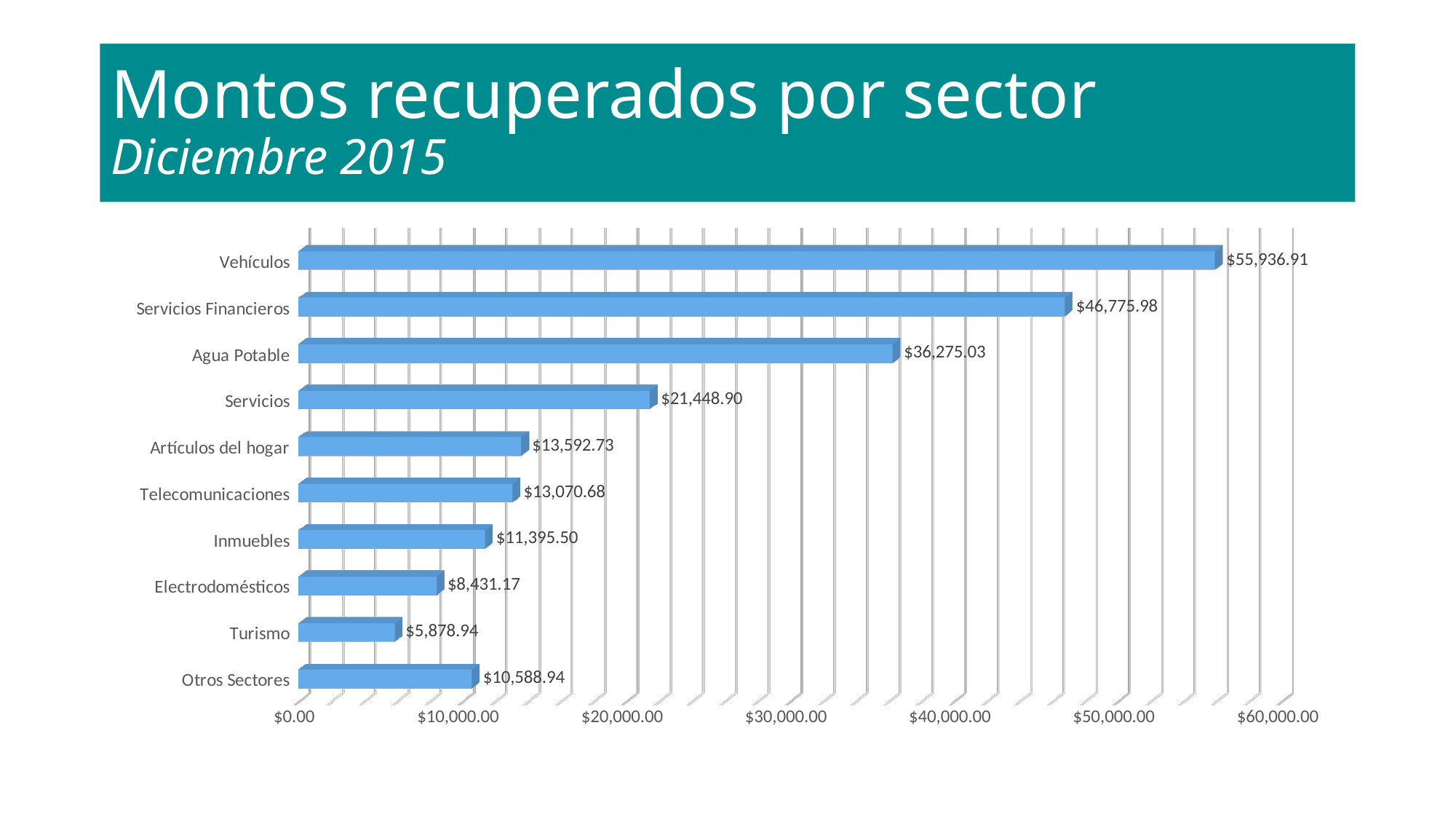
Which sector has the highest recovered amount? Vehículos What kind of chart is shown on the slide? Bar chart What is the value for Vehículos? $55,936.91 What is the value for Otros Sectores? $10,588.94 What is the title of the slide? Montos recuperados por sector Diciembre 2015 Is the value for Servicios greater or less than $20,000.00? greater What is the difference between the values for Vehículos and Servicios Financieros? $9,160.93 Which is larger, the value for Inmuebles or the value for Otros Sectores? Inmuebles What is the value for Turismo? $5,878.94 Which sector has the lowest recovered amount? Turismo How many sectors are shown in the chart? 10 What is the value for Agua Potable? $36,275.03